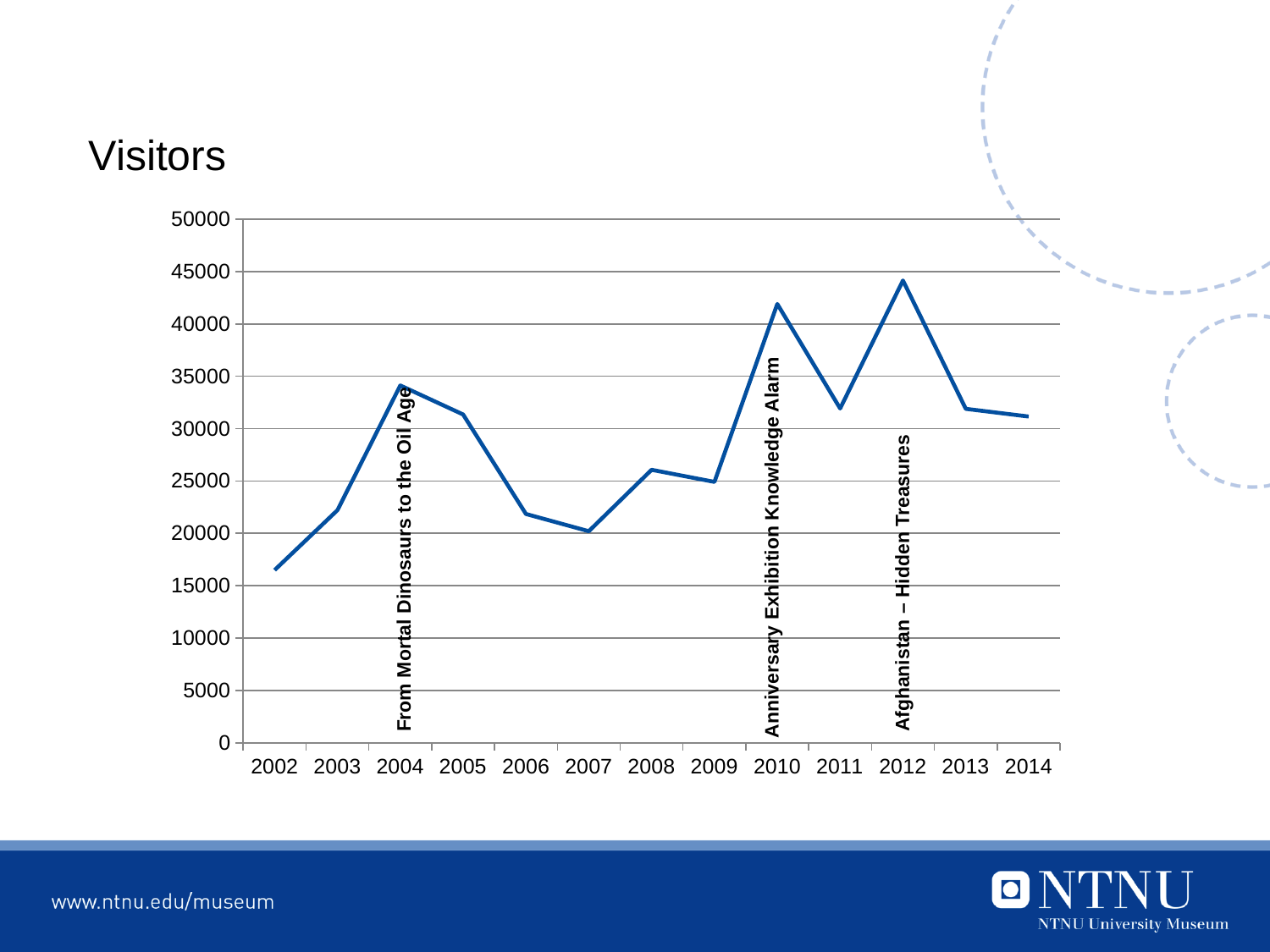
Is the value for 2010 greater or less than 40000? greater Which year has more visitors, 2008 or 2006? 2008 Which exhibition is labelled on the chart at the year 2012? Afghanistan – Hidden Treasures Which year has the lowest number of visitors? 2002 What kind of chart is shown on the slide? line chart Do visitor numbers rise or fall from 2004 to 2007? fall Is the value for 2004 greater or less than 30000? greater Is the value for 2002 greater or less than 20000? less Which year has more visitors, 2010 or 2011? 2010 Which year has the highest number of visitors? 2012 How many years are plotted along the x axis of the Visitors chart? 13